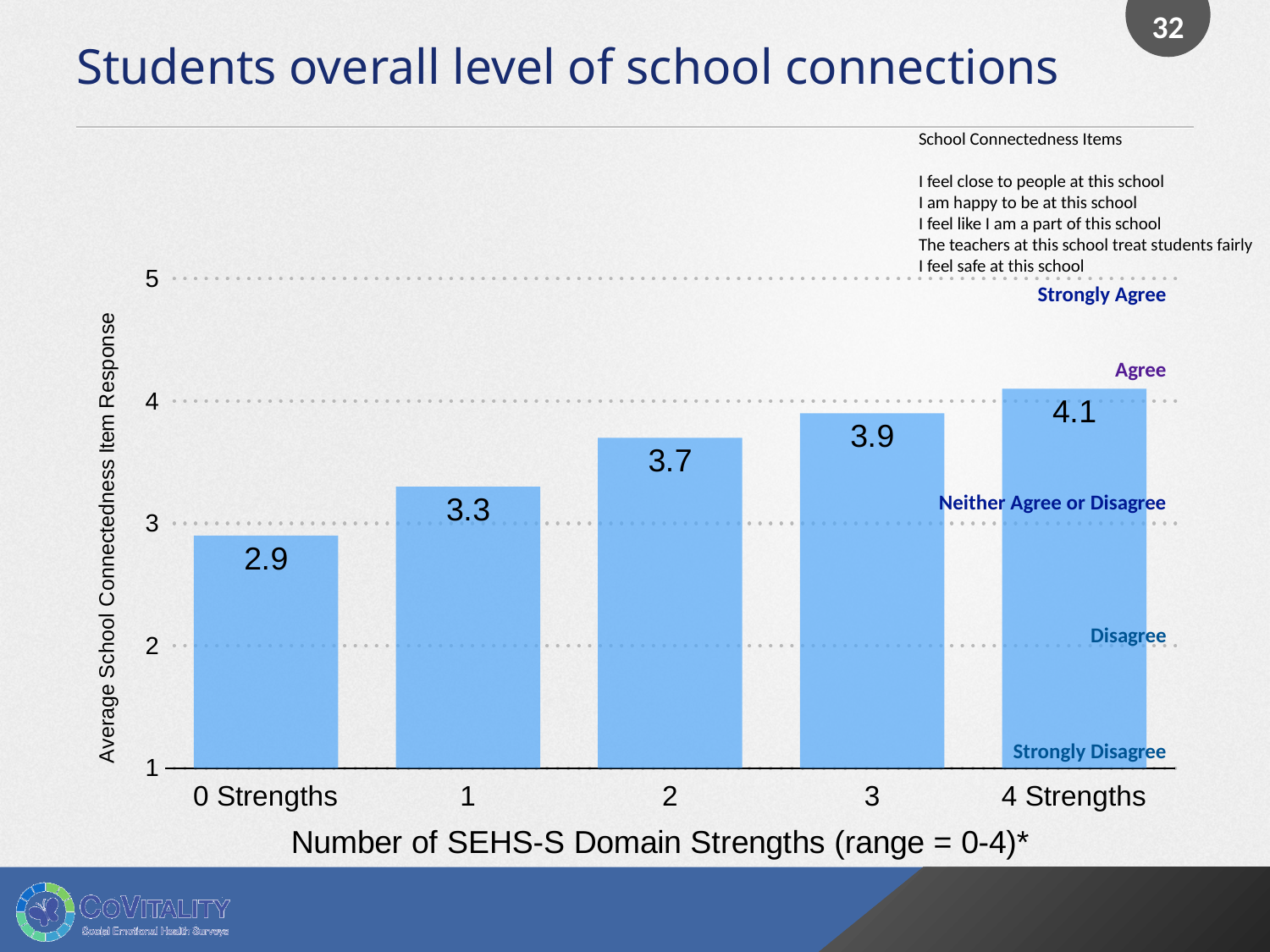
Which category has the lowest average school connectedness item response? 0 Strengths Is the value for 0 Strengths greater or less than 3? less Which category has the highest average school connectedness item response? 4 Strengths What kind of chart is shown on the slide? bar chart What is the difference between the values for 4 Strengths and 0 Strengths? 1.2 What is the average school connectedness item response for students with 0 Strengths? 2.9 What is the average school connectedness item response for students with 4 Strengths? 4.1 What is the title of the x axis? Number of SEHS-S Domain Strengths (range = 0-4)* What is the value shown for the bar labelled 2 on the x axis? 3.7 Which is larger, the value for 1 strength or the value for 3 strengths? 3 strengths How many bars are shown in the chart? 5 Do the values rise or fall as the number of SEHS-S domain strengths increases? rise